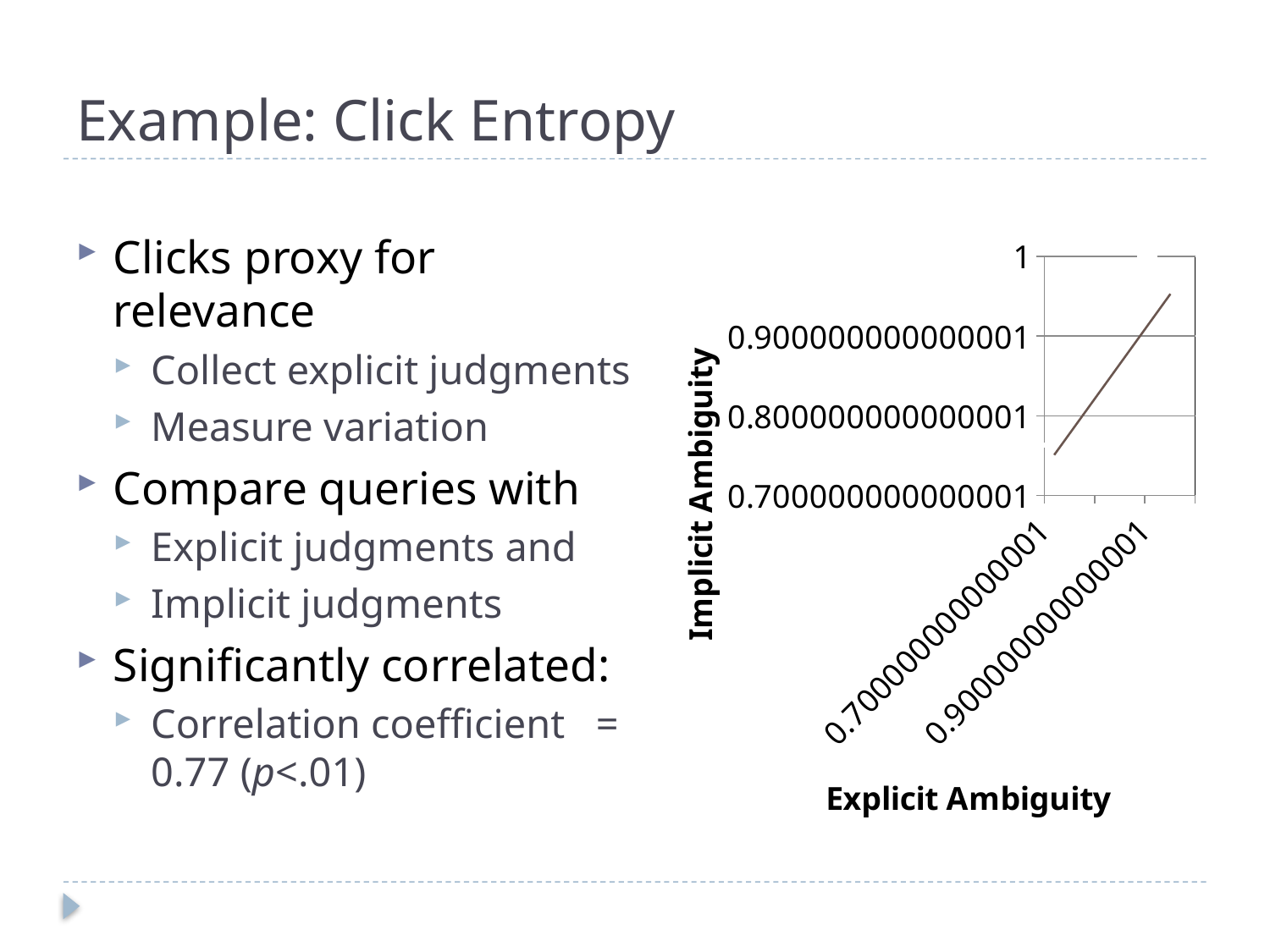
Is the Implicit Ambiguity value at the left end of the line greater or less than 0.800000000000001? less Do the values in the chart rise or fall as Explicit Ambiguity increases along the x axis? rise Is the Implicit Ambiguity value at the left end of the line greater or less than 0.700000000000001? greater What kind of chart is shown on the slide? line chart What is the highest tick value shown on the y axis of the chart? 1 Is the Implicit Ambiguity value at the right end of the line greater or less than 0.900000000000001? greater What is the title of the x axis of the chart? Explicit Ambiguity What is the title of the y axis of the chart? Implicit Ambiguity Which end of the line has the higher Implicit Ambiguity value, the left end or the right end? right end